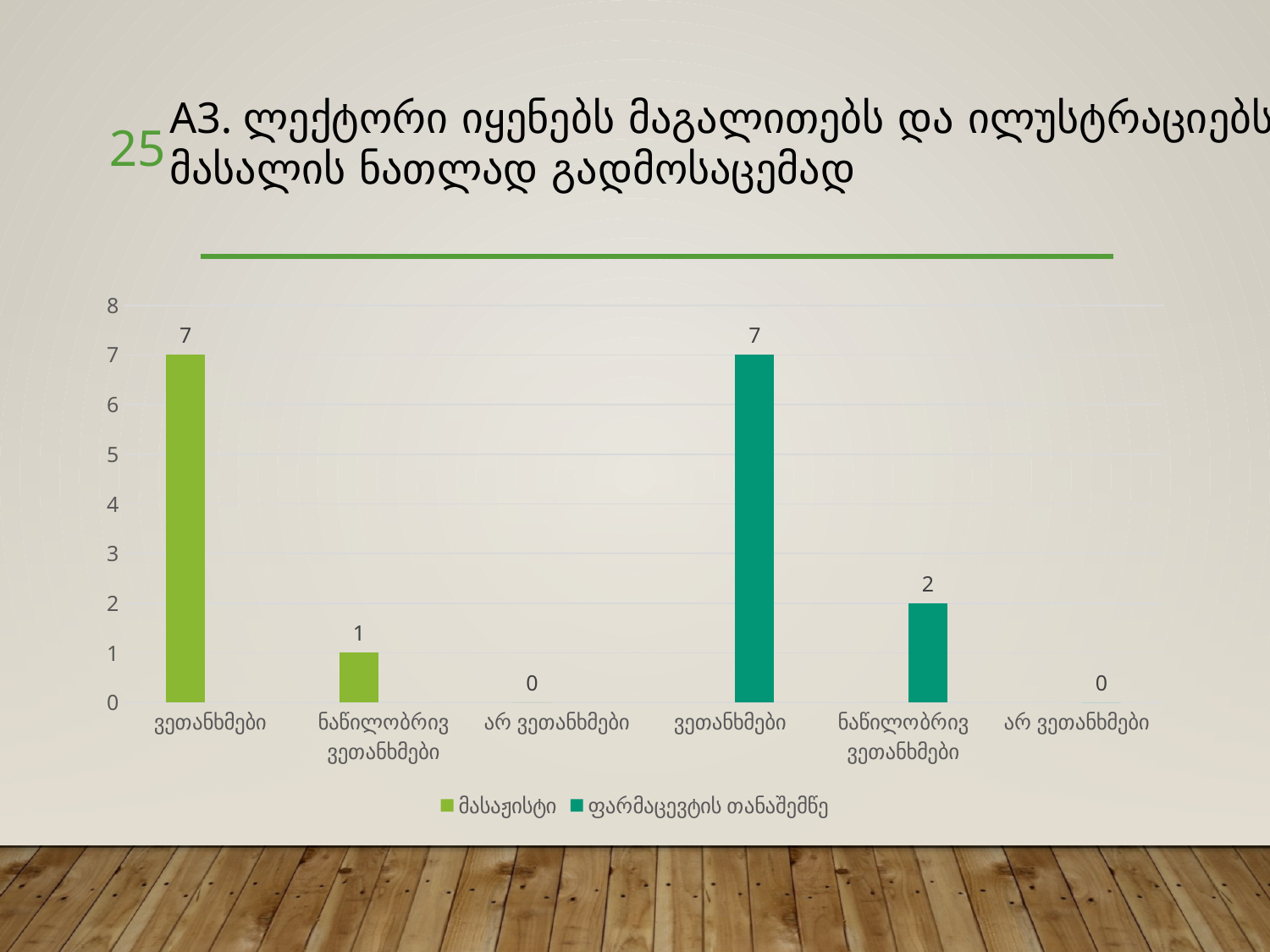
What is the difference between the "ვეთანხმები" value and the "ნაწილობრივ ვეთანხმები" value in the მასაჟისტი series? 6 What is the value of the "არ ვეთანხმები" bar for the ფარმაცევტის თანაშემწე series? 0 What is the value of the first "ვეთანხმები" bar (მასაჟისტი series)? 7 Which is larger: the "ნაწილობრივ ვეთანხმები" value for მასაჟისტი or for ფარმაცევტის თანაშემწე? ფარმაცევტის თანაშემწე What is the value of the "ნაწილობრივ ვეთანხმები" bar for the მასაჟისტი series? 1 What is the difference between the "ნაწილობრივ ვეთანხმები" values of the ფარმაცევტის თანაშემწე series and the მასაჟისტი series? 1 What is the highest value shown on the vertical axis? 8 How many category labels are shown along the x axis? 6 Which series is shown in teal (dark green) in the legend? ფარმაცევტის თანაშემწე How many series does the legend list? 2 What kind of chart is shown on the slide? bar chart What is the value of the "ნაწილობრივ ვეთანხმები" bar for the ფარმაცევტის თანაშემწე series? 2